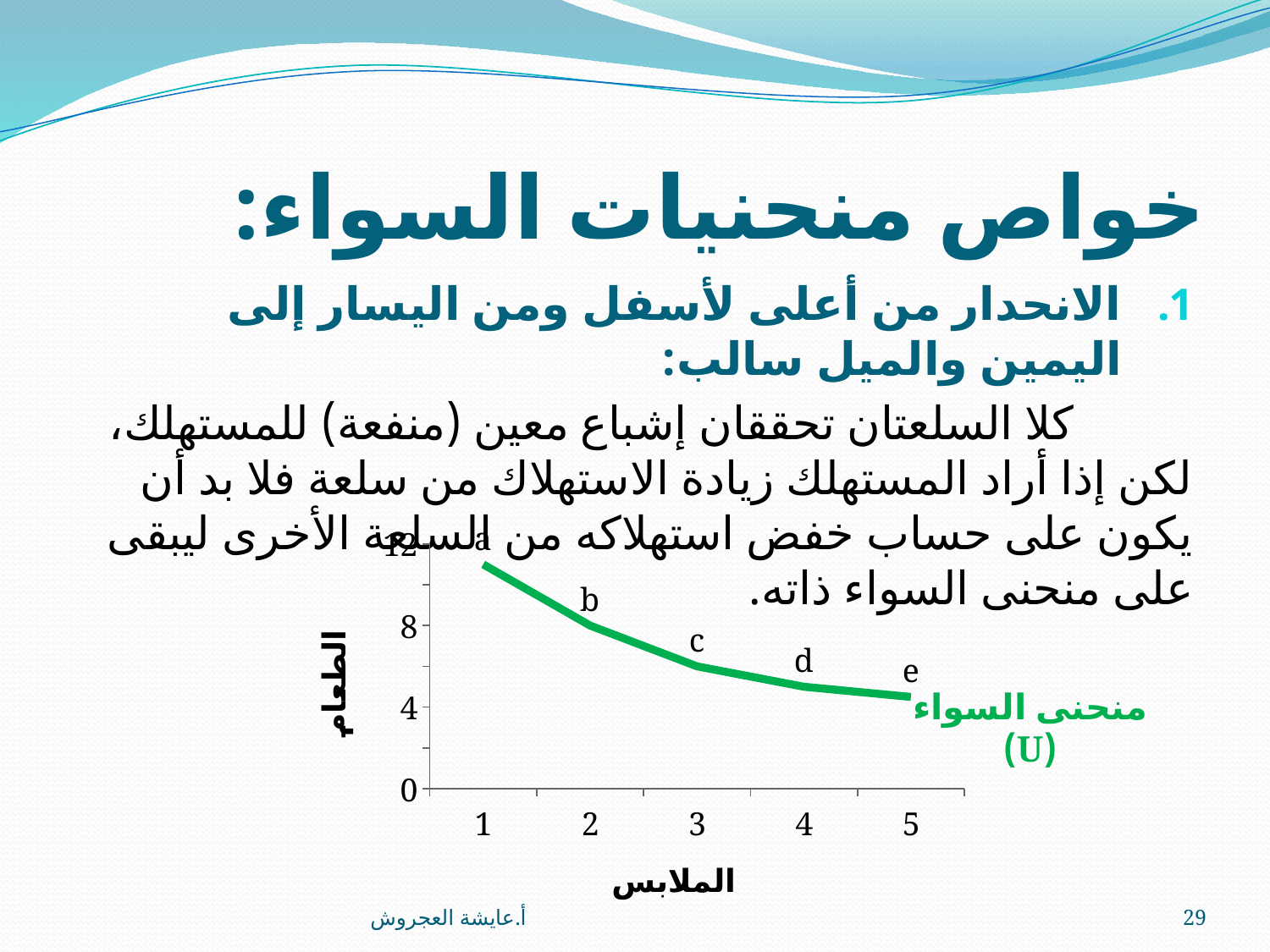
What kind of chart is shown on the slide? line chart Is the value of الطعام at point e greater or less than 8? less Do the values rise or fall as الملابس increases along the x axis? fall What is the value of الطعام at point b? 8 Is the value of الطعام at point c greater or less than 8? less Which point has the highest value of الطعام? a Which is larger, the value of الطعام at point a or at point c? a How many labelled points are plotted on the curve? 5